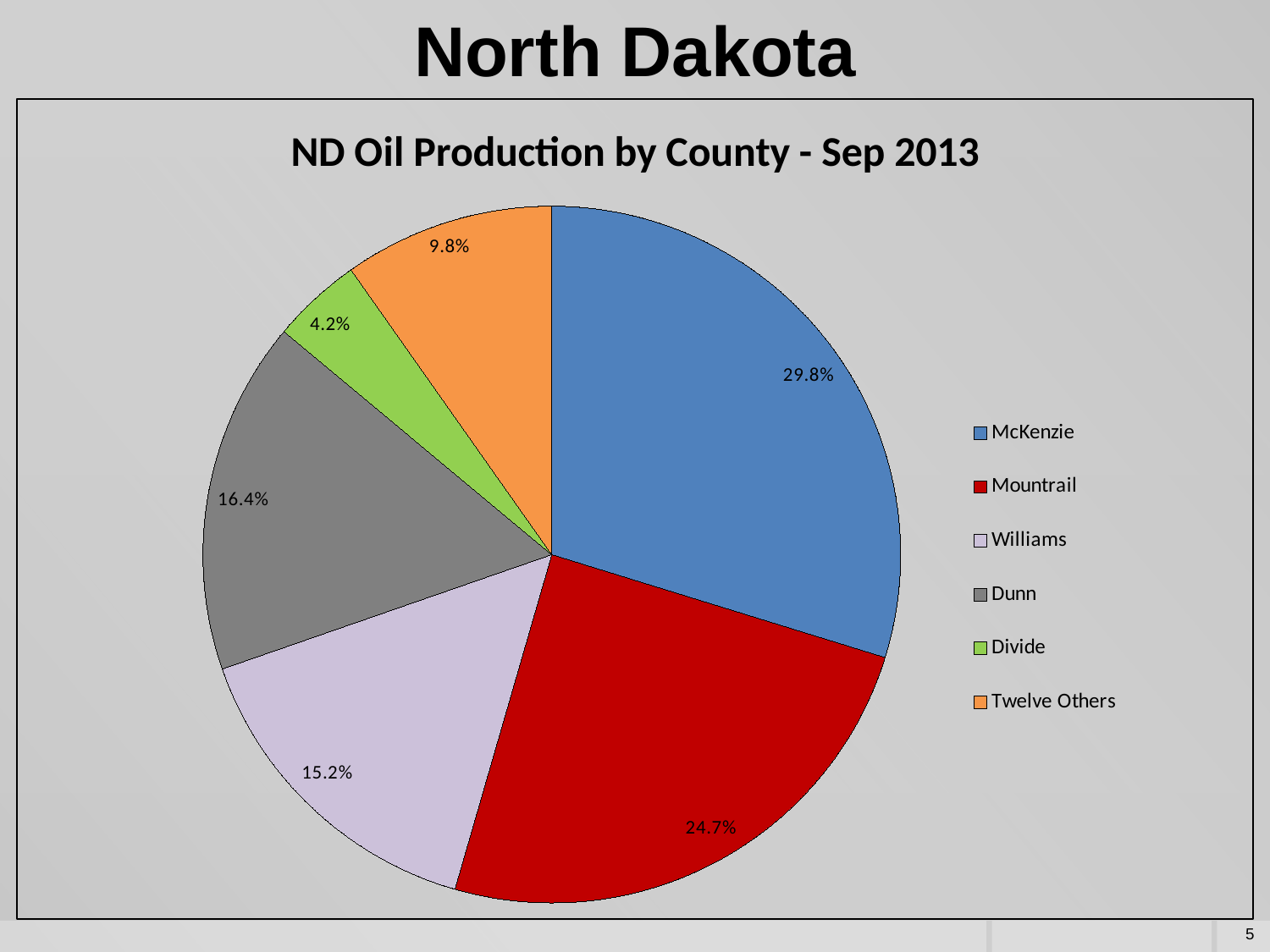
What is the title of the chart? ND Oil Production by County - Sep 2013 What share of ND oil production does McKenzie county account for? 29.8% What percentage is shown for Divide? 4.2% What share of production is attributed to Twelve Others? 9.8% Which county has the largest share of oil production? McKenzie What percentage is shown for Mountrail? 24.7% What is the difference in percentage points between McKenzie and Mountrail? 5.1 Which slice of the pie is the smallest? Divide What percentage is shown for Dunn? 16.4% How many slices does the pie chart have? 6 What percentage is shown for Williams? 15.2% What kind of chart is shown on the slide? pie chart